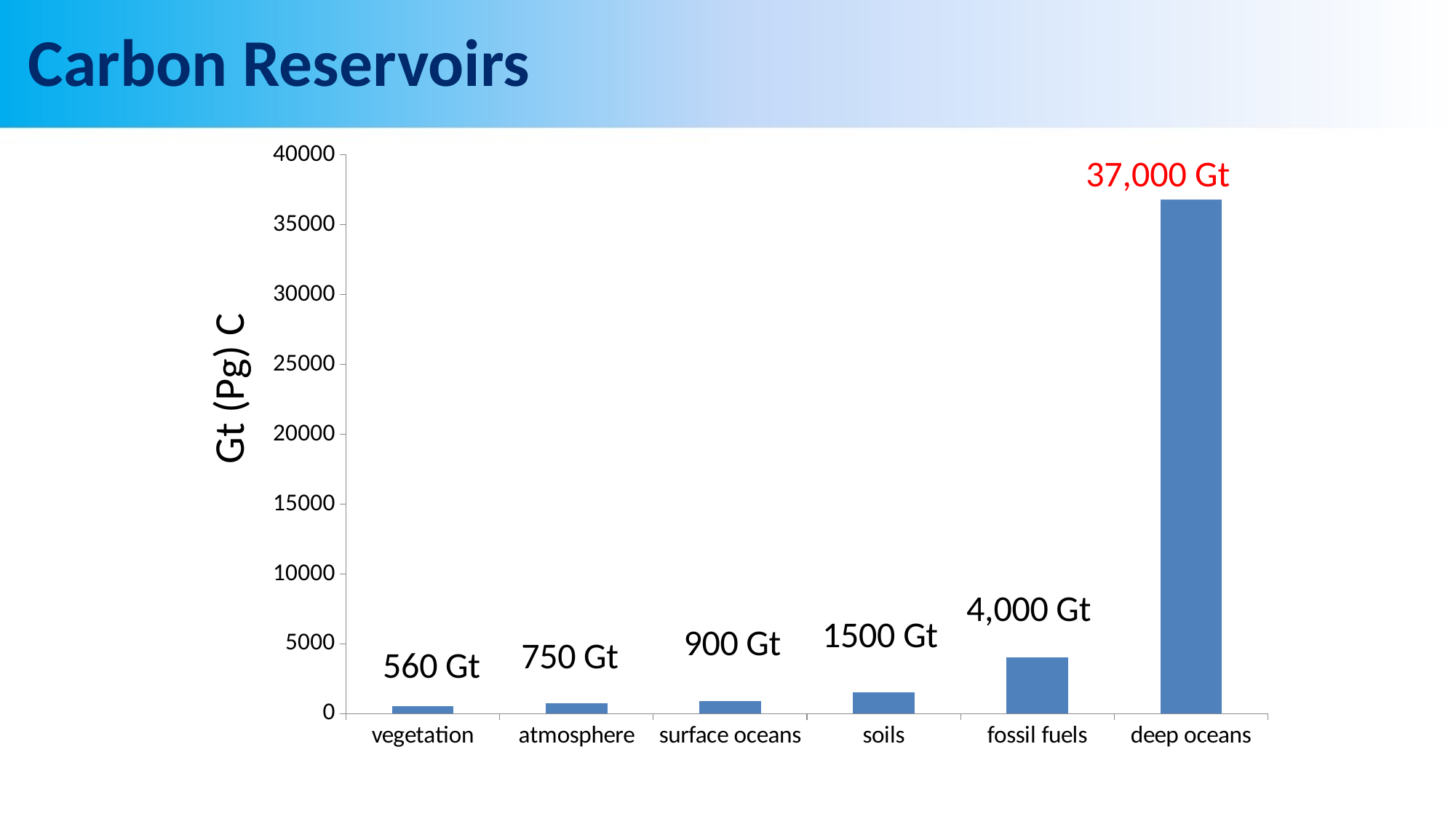
What is the value for fossil fuels? 4,000 Gt Which category has the lowest value? vegetation What is the label on the y axis? Gt (Pg) C Is the value for fossil fuels greater or less than 5000? less What kind of chart is shown on the slide? bar chart What is the value for deep oceans? 37,000 Gt What is the value for soils? 1500 Gt Which category has the highest value? deep oceans How many categories are shown on the x axis? 6 What is the difference between the values for atmosphere and vegetation? 190 Gt Which is larger, the value for surface oceans or the value for soils? soils What is the value for vegetation? 560 Gt